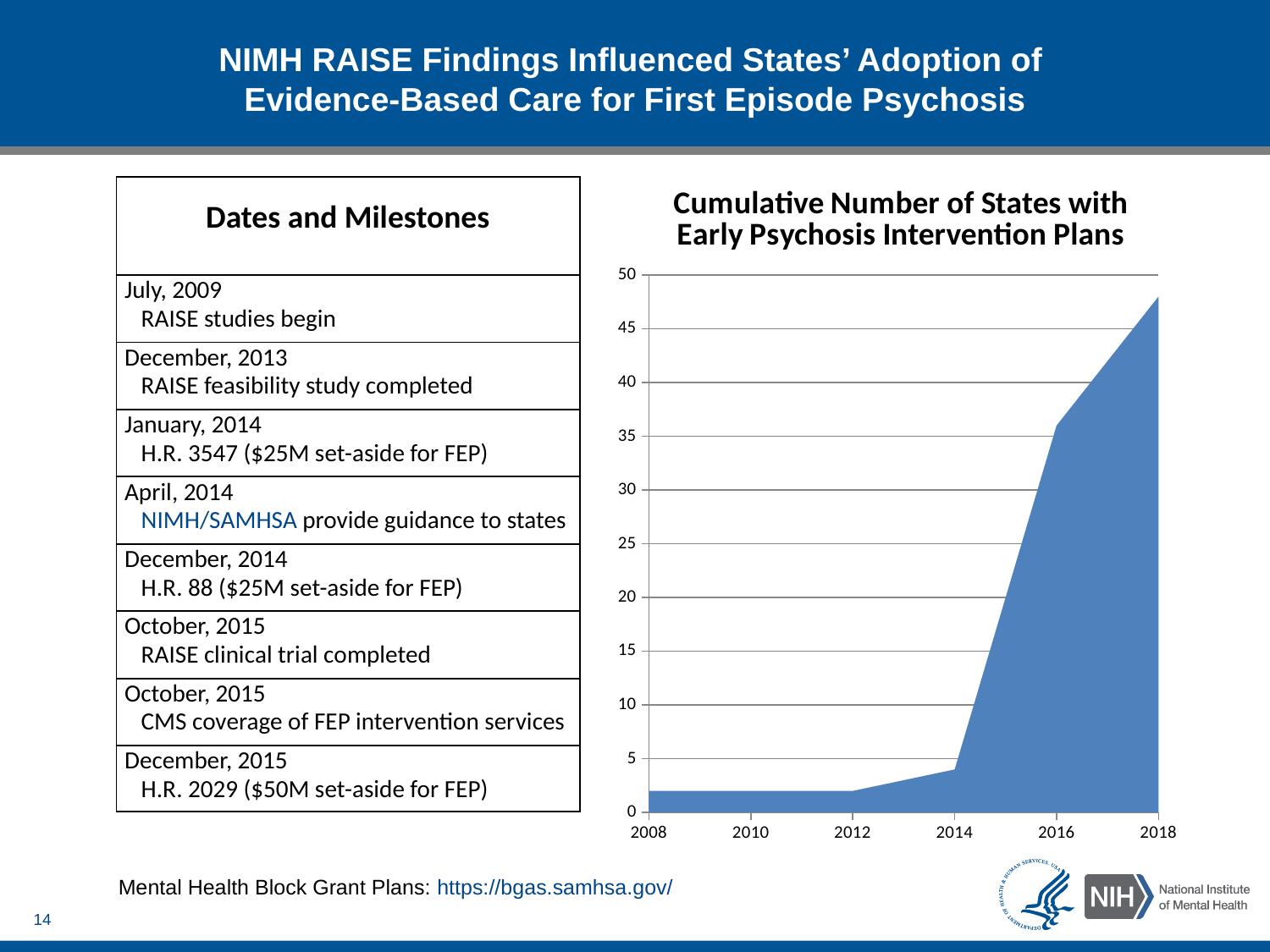
What is the highest value shown on the y axis? 50 Is the value for 2012 greater or less than 5? less Is the value for 2014 greater or less than 5? less Which year shown on the x axis has the highest value? 2018 What is the title of the chart? Cumulative Number of States with Early Psychosis Intervention Plans Is the value for 2016 greater or less than 35? greater How many year labels are shown on the x axis? 6 Do the values in the chart rise or fall from 2008 to 2018? Rise What kind of chart is shown on the slide? Area chart Which is larger, the value for 2014 or the value for 2016? 2016